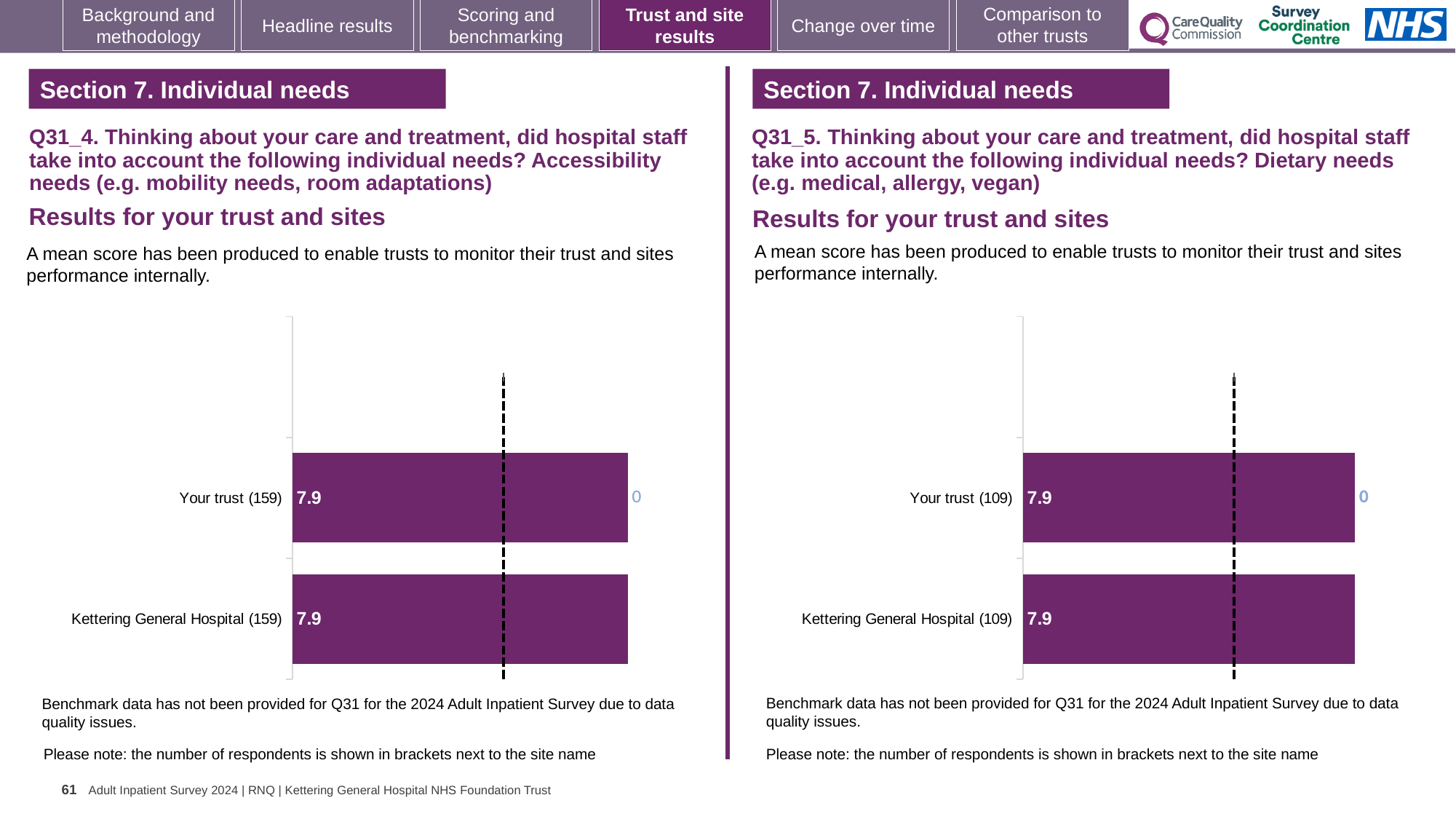
In the Q31_4 chart on the left (Accessibility needs), what is the mean score for Your trust? 7.9 In the Q31_5 chart on the right, how many respondents are shown in brackets next to Kettering General Hospital? 109 How many bars are plotted in the Q31_5 chart on the right? 2 In the Q31_5 chart on the right (Dietary needs), what is the mean score for Kettering General Hospital? 7.9 In the Q31_5 chart on the right (Dietary needs), what is the mean score for Your trust? 7.9 How many bars are plotted in the Q31_4 chart on the left? 2 What type of chart is used for the Q31_5 results on the right? Bar chart In the Q31_4 chart on the left, what is the difference between the mean score for Your trust and the mean score for Kettering General Hospital? 0.0 What type of chart is used for the Q31_4 results on the left? Bar chart In the Q31_4 chart on the left, how many respondents are shown in brackets next to Your trust? 159 In the Q31_5 chart on the right, what is the difference between the mean score for Your trust and the mean score for Kettering General Hospital? 0.0 In the Q31_4 chart on the left (Accessibility needs), what is the mean score for Kettering General Hospital? 7.9